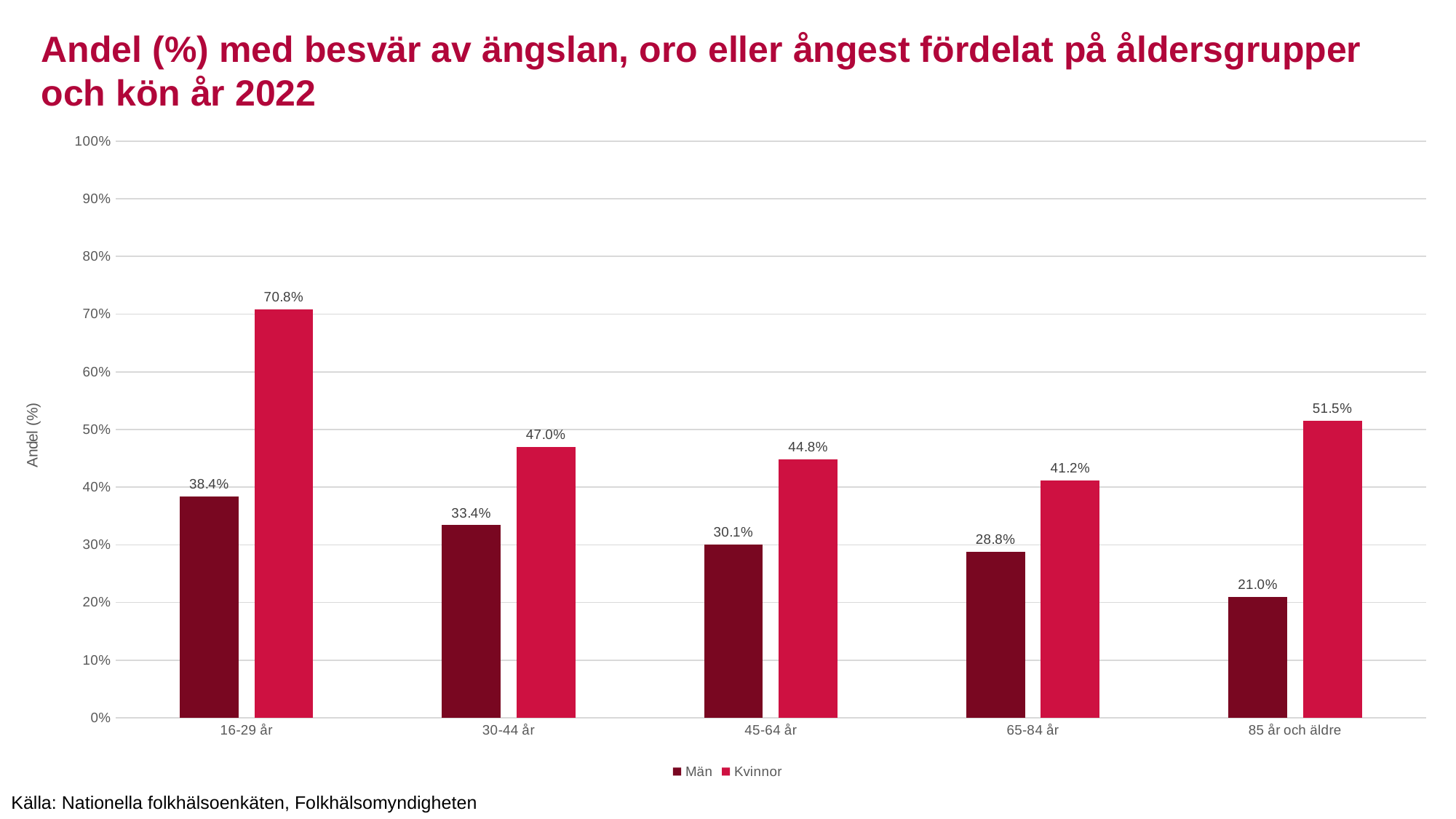
How many series does the legend list? 2 Which age group has the highest value for Kvinnor? 16-29 år What is the label of the y axis? Andel (%) Which age group has the lowest value for Män? 85 år och äldre What is the value for Män in the 45-64 år age group? 30.1% How many age groups are shown on the x axis? 5 What kind of chart is shown on the slide? Bar chart Do the values for Män rise or fall from 16-29 år to 85 år och äldre? Fall What is the difference between Kvinnor and Män in the 30-44 år age group? 13.6 percentage points What is the value for Kvinnor in the 16-29 år age group? 70.8% What is the value for Män in the 85 år och äldre age group? 21.0% Which is larger: Kvinnor in 65-84 år or Kvinnor in 45-64 år? Kvinnor in 45-64 år